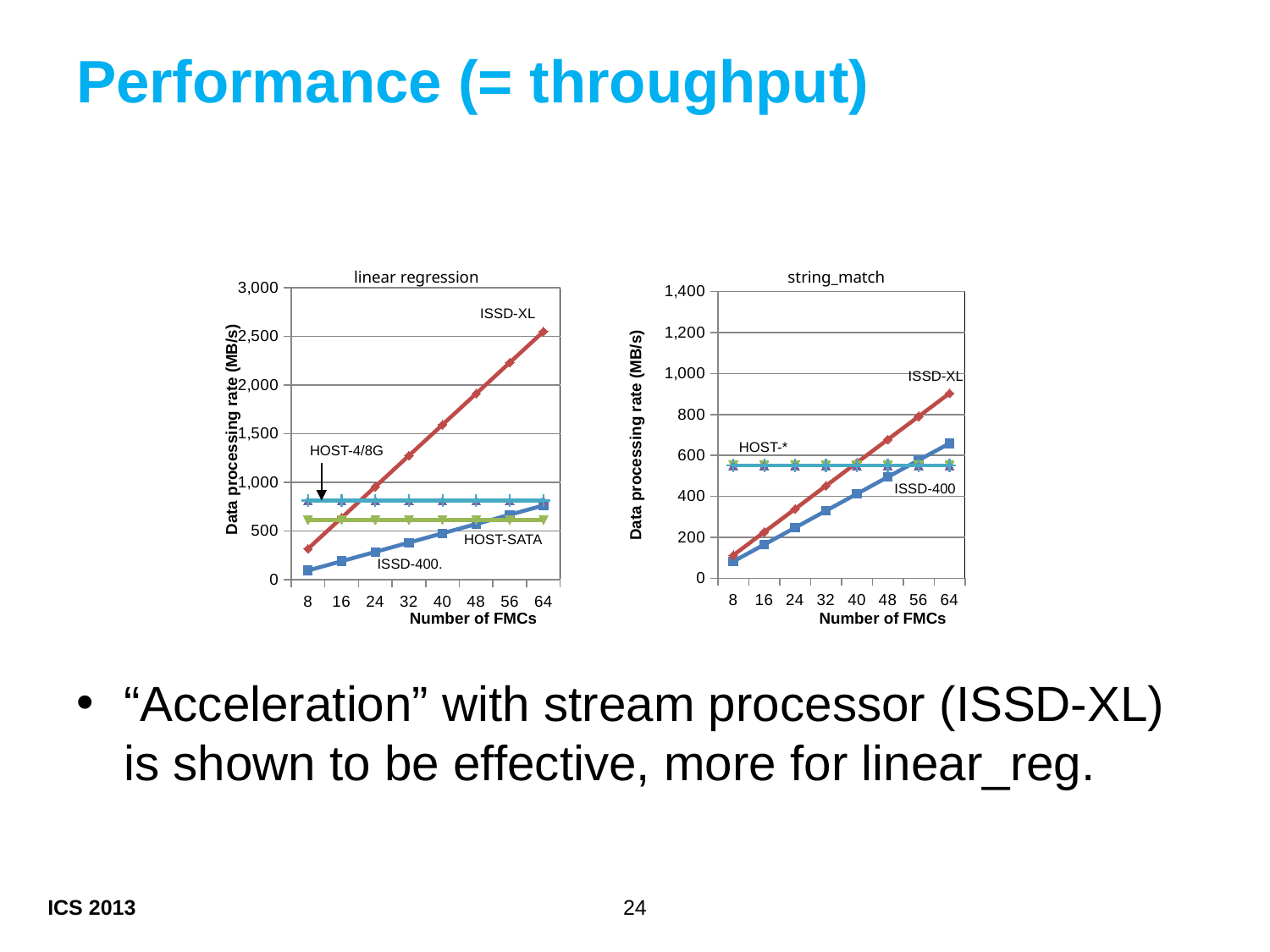
In the 'linear regression' chart, is the ISSD-XL value at 64 FMCs greater or less than 2,000? greater In the 'linear regression' chart, is the ISSD-400 value at 8 FMCs greater or less than 500? less In the 'string_match' chart, does the HOST-* series rise, fall or stay flat as the number of FMCs increases? stays flat In the 'linear regression' chart, which series is higher, HOST-4/8G or HOST-SATA? HOST-4/8G In the 'string_match' chart, which series has the highest data processing rate at 64 FMCs? ISSD-XL What kind of chart is the 'linear regression' chart? line chart What is the y-axis label of the 'string_match' chart? Data processing rate (MB/s) In the 'linear regression' chart, does the ISSD-XL series rise or fall as the number of FMCs increases? rises In the 'linear regression' chart, how many Number of FMCs values are plotted along the x axis? 8 In the 'linear regression' chart, which series has the highest data processing rate at 64 FMCs? ISSD-XL In the 'string_match' chart, is the ISSD-400 value at 8 FMCs greater or less than 200? less